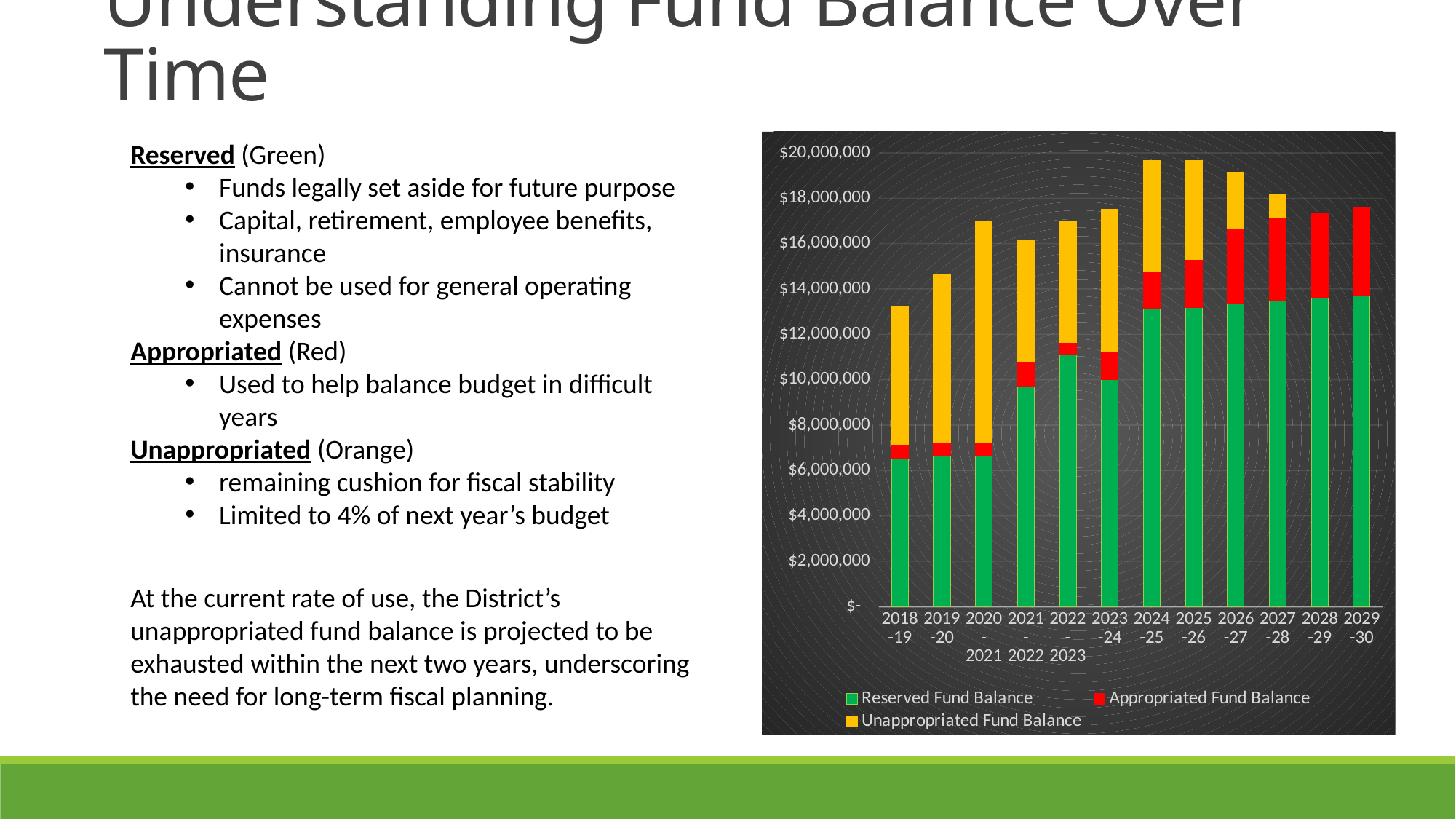
Which year has the larger total fund balance, 2018-19 or 2020-21? 2020-21 What kind of chart is shown on the slide? Stacked bar chart Does the Reserved Fund Balance generally rise or fall from 2018-19 to 2029-30? rise Is the total fund balance for 2024-25 greater or less than $18,000,000? greater Is the Reserved Fund Balance for 2029-30 greater or less than $12,000,000? greater Which series is shown in orange in the chart's legend? Unappropriated Fund Balance Is the Reserved Fund Balance for 2018-19 greater or less than $8,000,000? less Which year has the largest Unappropriated Fund Balance? 2020-2021 How many fiscal years are shown along the x axis of the chart? 12 Which year has the lowest total fund balance? 2018-19 How many series does the chart's legend list? 3